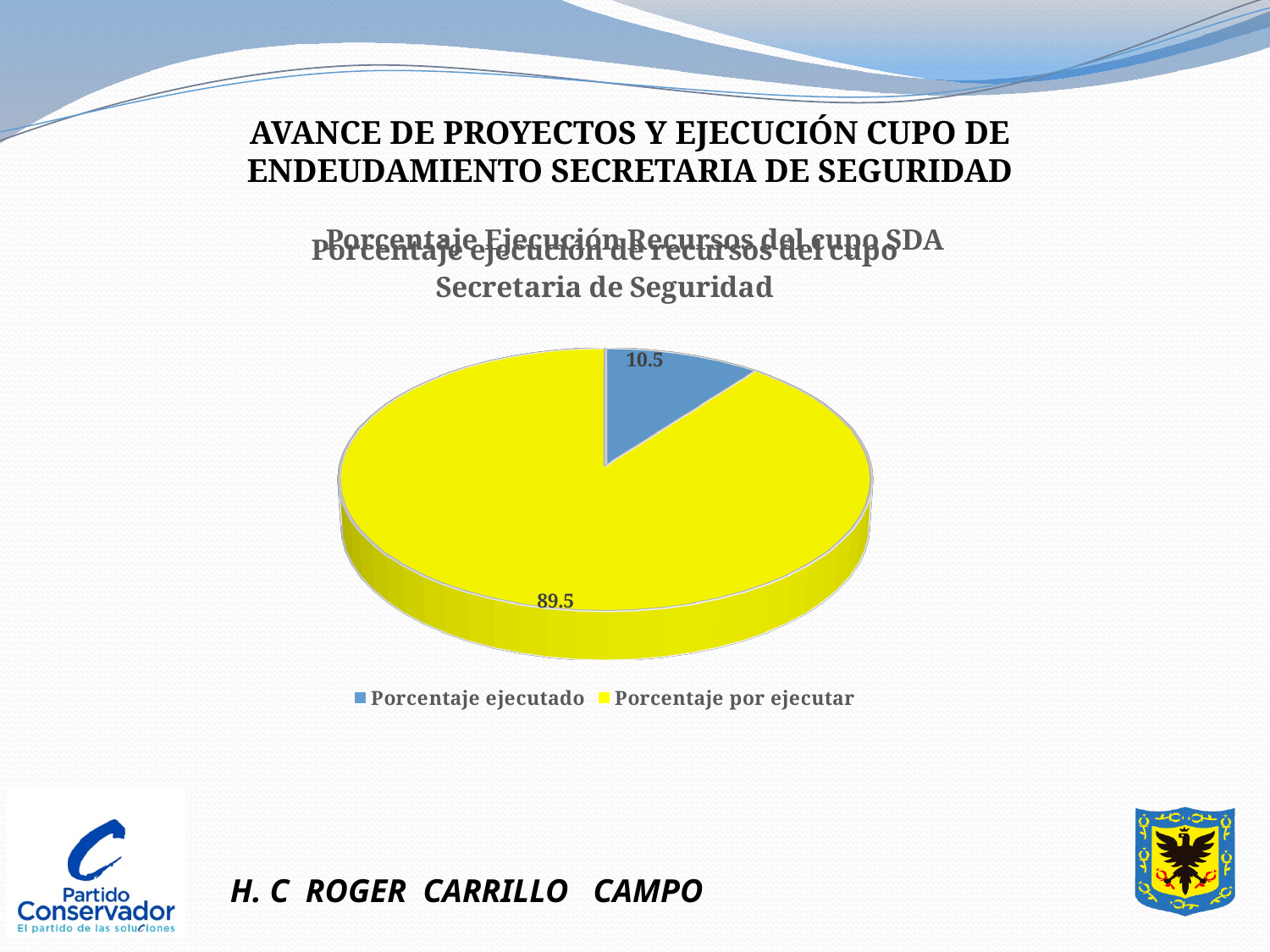
How many slices does the pie chart have? 2 What colour is the Porcentaje por ejecutar slice? yellow Which slice is the largest? Porcentaje por ejecutar Which slice is the smallest? Porcentaje ejecutado What is the total of the two slice values? 100 How many entries does the legend list? 2 What is the value for Porcentaje por ejecutar? 89.5 What is the value for Porcentaje ejecutado? 10.5 What colour is the Porcentaje ejecutado slice? blue What kind of chart is shown on the slide? pie chart What is the difference between Porcentaje por ejecutar and Porcentaje ejecutado? 79 Which is larger, Porcentaje ejecutado or Porcentaje por ejecutar? Porcentaje por ejecutar